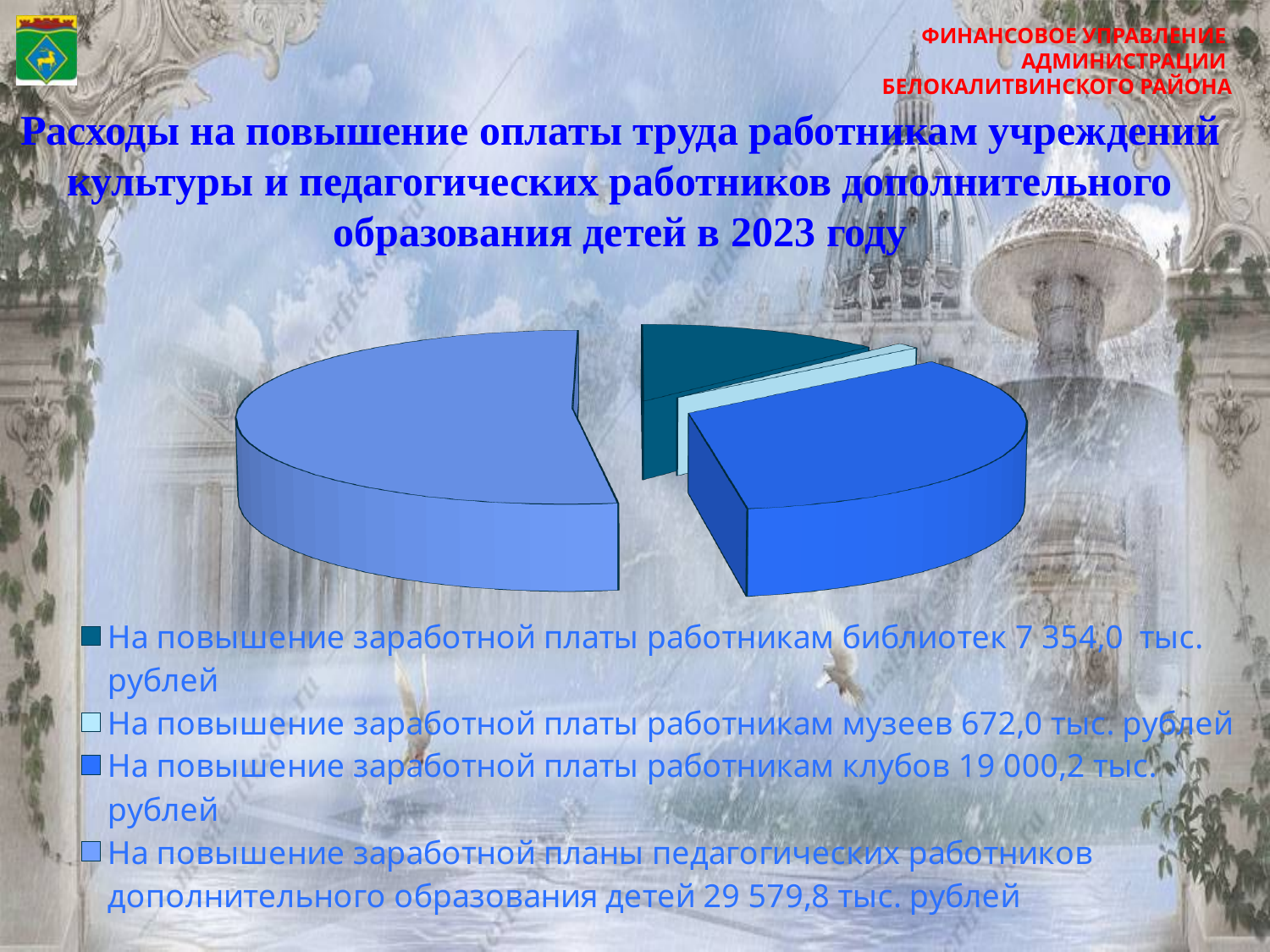
What is the amount for raising wages of library workers (работникам библиотек)? 7 354,0 тыс. рублей What kind of chart is shown on the slide? Pie chart What is the amount for raising wages of club workers (работникам клубов)? 19 000,2 тыс. рублей What is the total of all four amounts shown in the legend? 56 606,0 тыс. рублей What is the amount for raising wages of museum workers (работникам музеев)? 672,0 тыс. рублей What is the amount for raising wages of pedagogical workers of children's additional education (педагогических работников дополнительного образования детей)? 29 579,8 тыс. рублей How many slices does the pie chart have? 4 How many entries does the legend of the pie chart list? 4 Which category has the smallest amount in the pie chart? Работникам музеев Which category has the largest amount in the pie chart? Педагогических работников дополнительного образования детей Which is larger: the amount for club workers or the amount for library workers? Работникам клубов What is the difference between the amount for pedagogical workers of additional education and the amount for club workers? 10 579,6 тыс. рублей